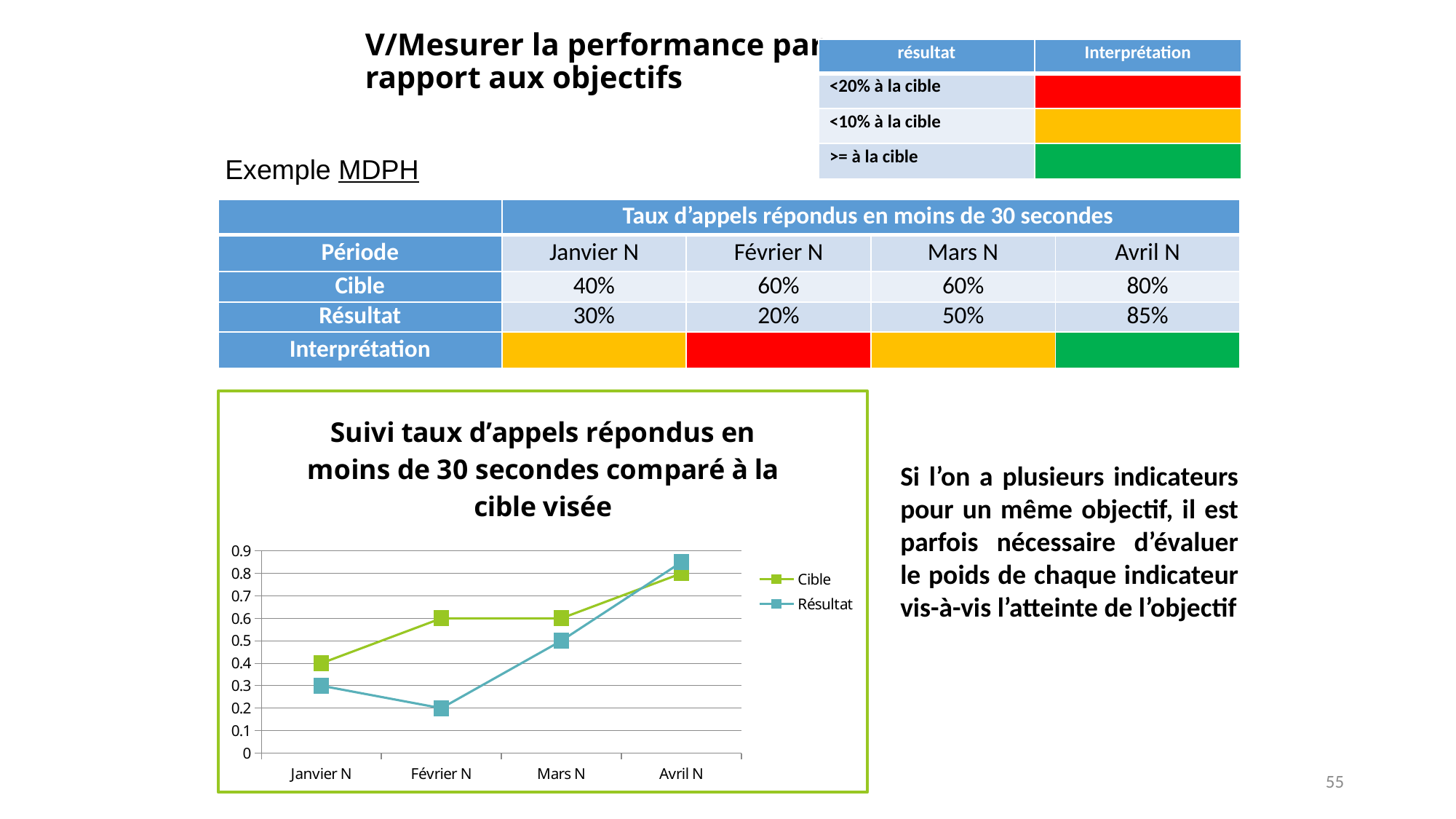
What is the Résultat value for Mars N in the chart? 0.5 What is the difference between the Cible and Résultat values for Février N? 0.4 How many periods are plotted along the x axis of the chart? 4 In which period is the Résultat series lowest? Février N What is the Cible value for Janvier N in the chart? 0.4 In which period is the Cible series highest? Avril N What is the Cible value for Avril N in the chart? 0.8 How many series does the chart legend list? 2 Is the Résultat value for Avril N greater or less than 0.8? greater What is the Résultat value for Février N in the chart? 0.2 What kind of chart is shown on the slide? line chart Which is larger in Mars N, the Cible value or the Résultat value? Cible